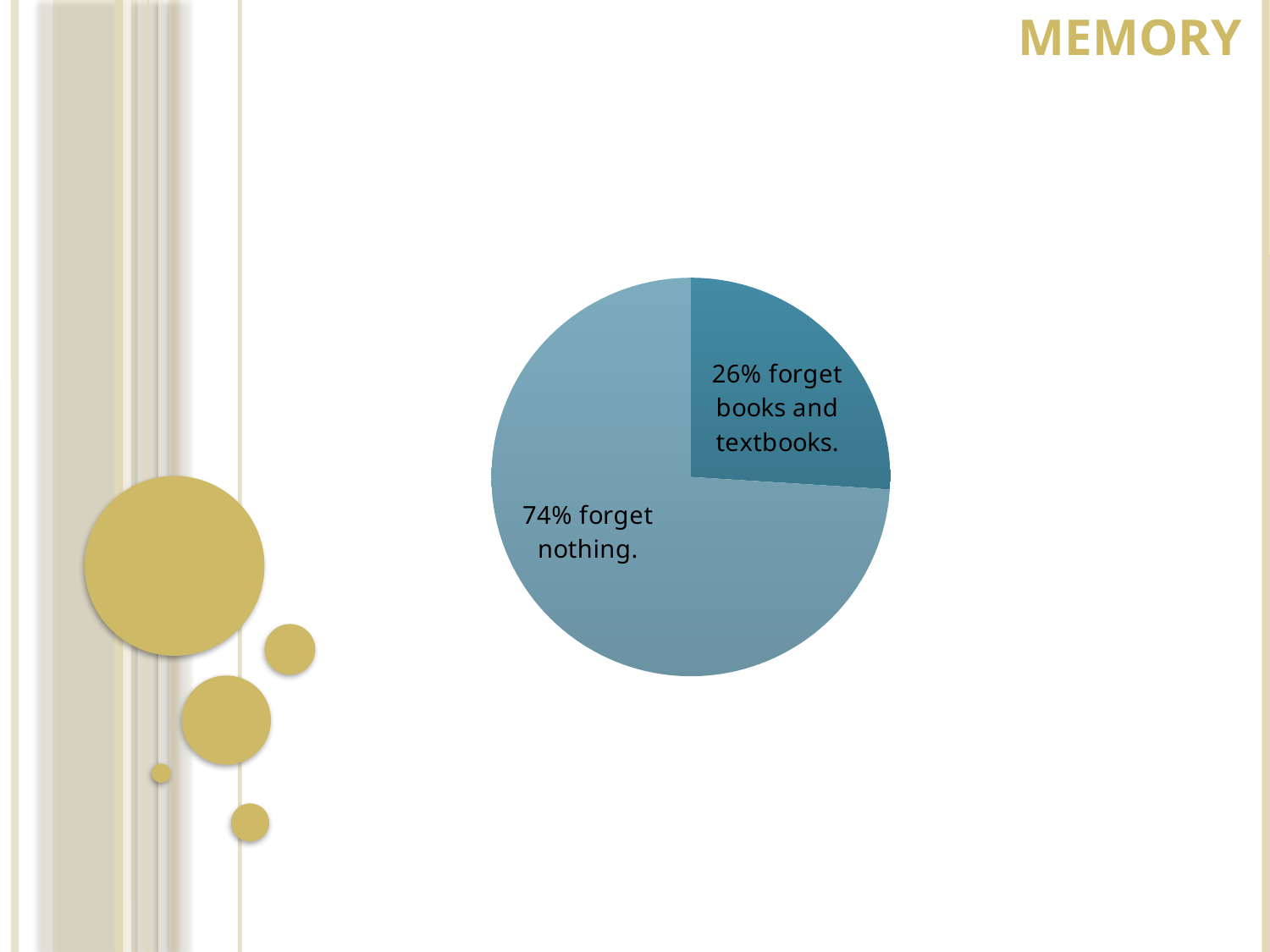
Which is larger: the share that forget nothing or the share that forget books and textbooks? forget nothing Which slice is shaded the darker blue: the one for forgetting nothing or the one for forgetting books and textbooks? forget books and textbooks What is the title of the slide containing the pie chart? MEMORY Is the share of people who forget nothing greater or less than 50%? greater Which slice of the pie is the smallest? 26% forget books and textbooks. Which slice of the pie is the largest? 74% forget nothing. What percentage of people forget nothing? 74% What is the difference in percentage points between the share that forget nothing and the share that forget books and textbooks? 48 What percentage of people forget books and textbooks? 26% What kind of chart is shown on the slide? pie chart How many slices does the pie chart have? 2 What share of the pie does the 'forget books and textbooks' slice represent? 26%